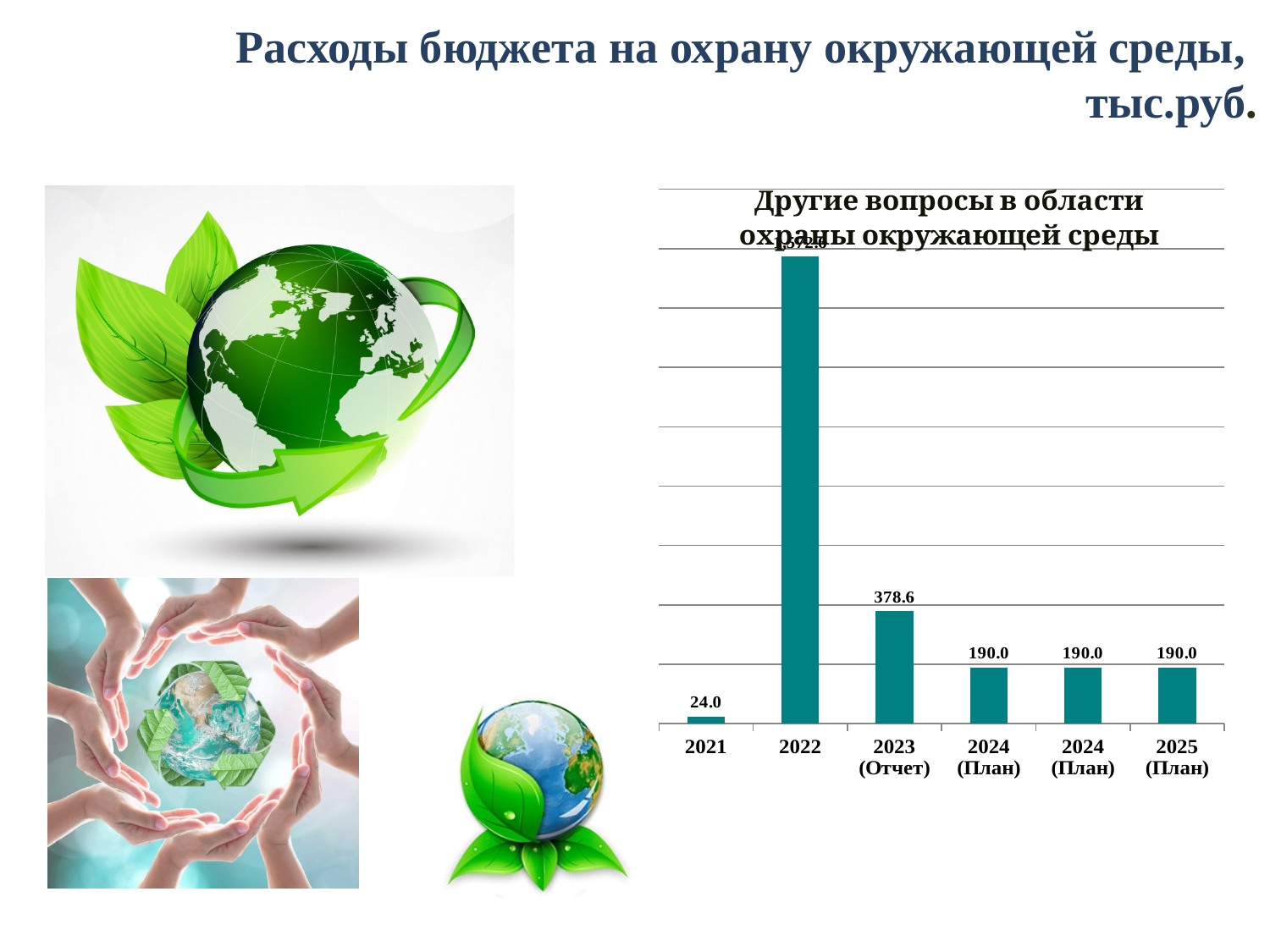
What is the value for 2023 (Отчет)? 378.6 What is the value for 2021? 24.0 Which category has the highest value? 2022 Do the values rise or fall from 2022 to 2025 (План)? fall What is the value for 2025 (План)? 190.0 How many bars are plotted in the chart? 6 Which category has the lowest value? 2021 What is the title of the chart? Другие вопросы в области охраны окружающей среды Which is larger, the value for 2021 or the value for 2025 (План)? 2025 (План) What is the difference between the values for 2023 (Отчет) and 2025 (План)? 188.6 What is the difference between the values for 2023 (Отчет) and 2021? 354.6 What type of chart is shown on the slide? bar chart